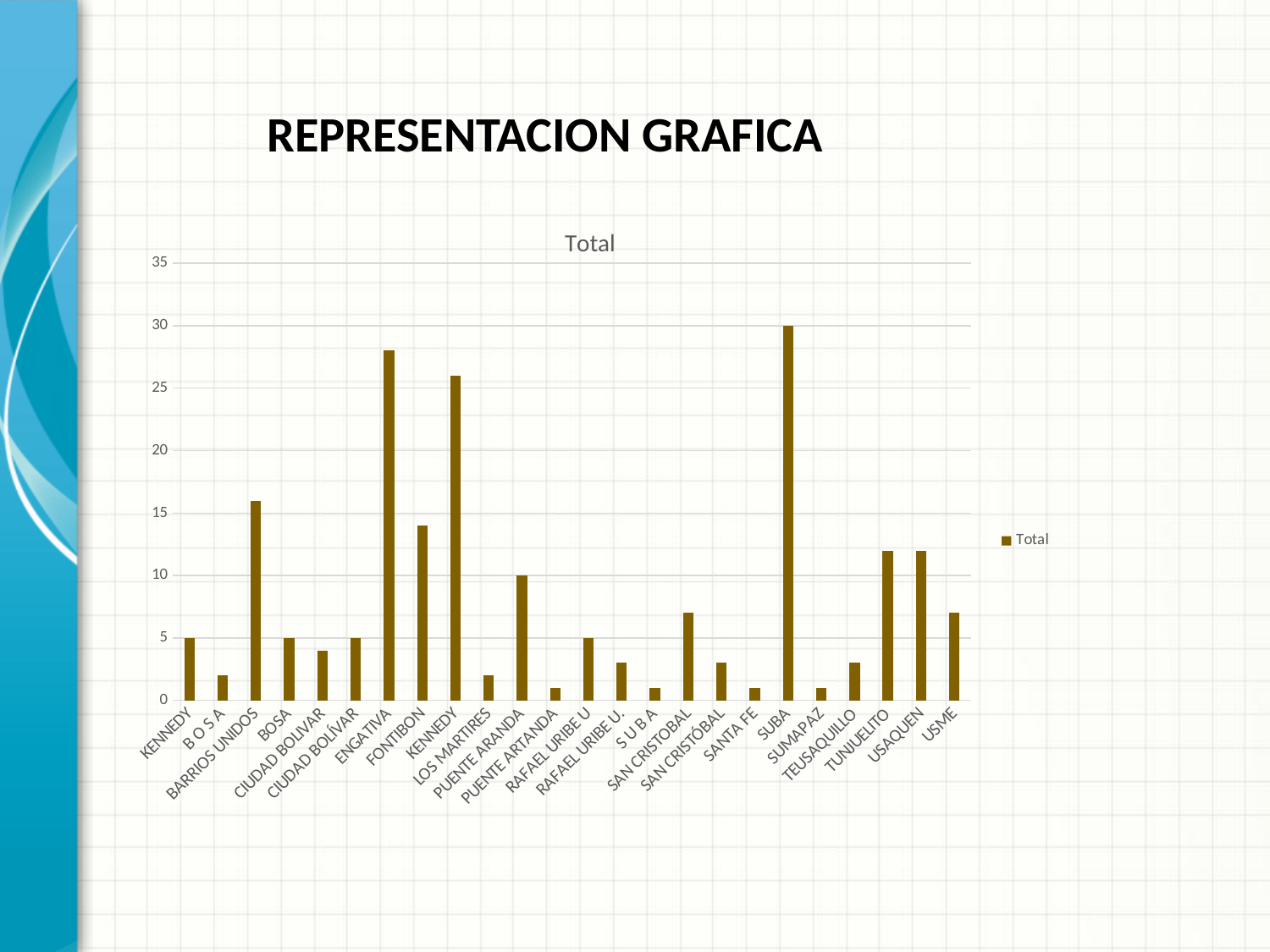
Which category has the highest value in the chart? SUBA How many categories are shown on the x axis of the chart? 24 Is the value for ENGATIVA greater or less than 25? greater Which is larger, the value for ENGATIVA or the value for FONTIBON? ENGATIVA Is the value for TUNJUELITO greater or less than 10? greater What type of chart is shown on the slide? bar chart What is the value for SUBA? 30 What is the title of the chart? Total What is the value for BOSA? 5 How many series does the legend list? 1 What is the value for PUENTE ARANDA? 10 Is the value for FONTIBON greater or less than 15? less